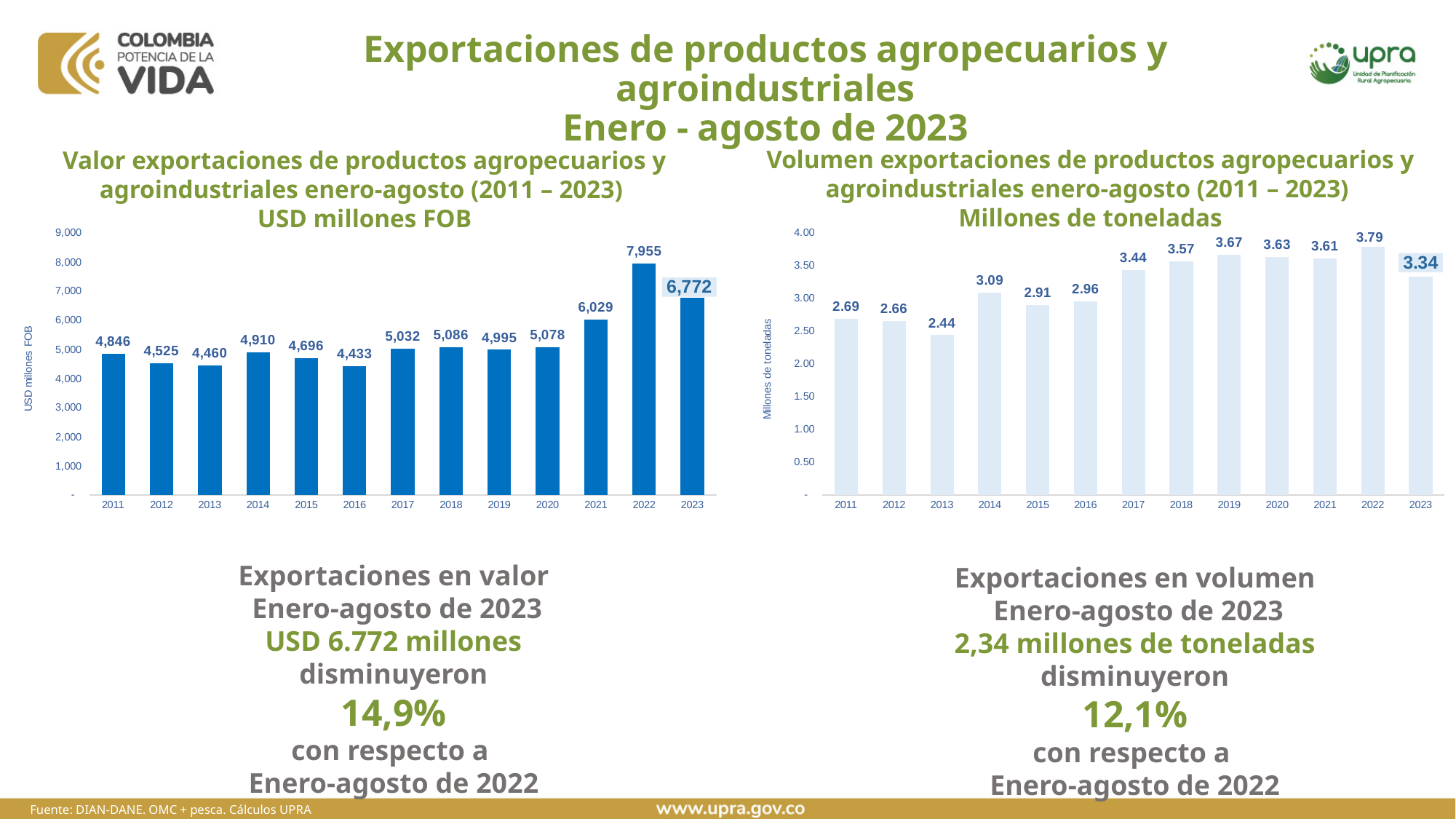
In the left chart (Valor exportaciones, USD millones FOB), which year has the highest value? 2022 In the left chart (Valor exportaciones, USD millones FOB), what is the value for 2022? 7,955 In the right chart (Volumen exportaciones, Millones de toneladas), what is the value for 2023? 3.34 In the left chart (Valor exportaciones, USD millones FOB), which year has the lowest value? 2016 In the left chart (Valor exportaciones, USD millones FOB), how many years are plotted? 13 In the right chart (Volumen exportaciones, Millones de toneladas), what is the difference between the 2022 and 2023 values? 0.45 What type of chart is the left chart (Valor exportaciones, USD millones FOB)? Bar chart In the right chart (Volumen exportaciones, Millones de toneladas), which year has the highest value? 2022 In the right chart (Volumen exportaciones, Millones de toneladas), which is larger, the value for 2014 or the value for 2015? 2014 In the left chart (Valor exportaciones, USD millones FOB), what is the value for 2016? 4,433 In the right chart (Volumen exportaciones, Millones de toneladas), which year has the lowest value? 2013 In the left chart (Valor exportaciones, USD millones FOB), what is the difference between the 2022 and 2023 values? 1,183